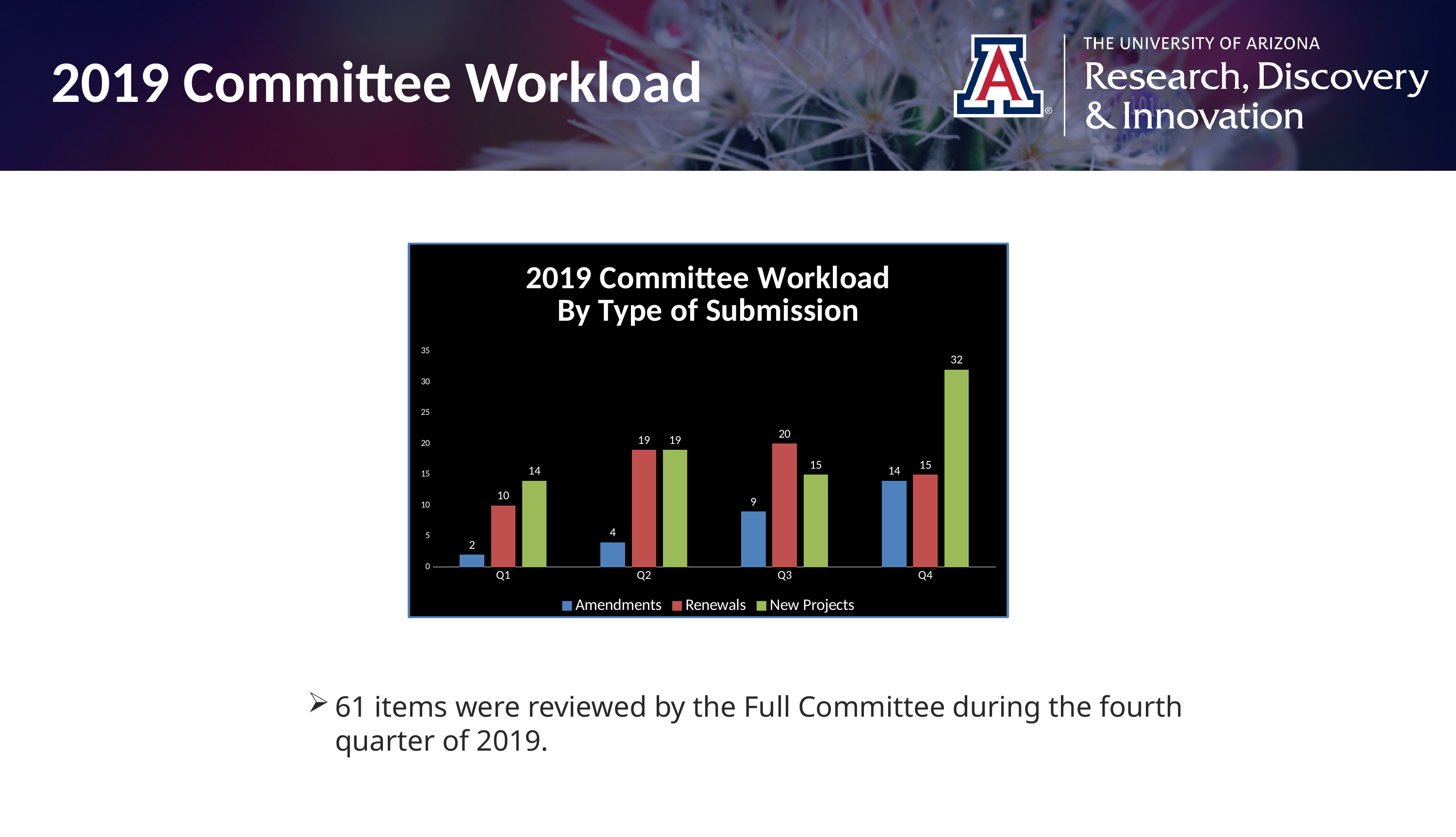
In which quarter is the Amendments value lowest? Q1 What is the value for New Projects in Q4? 32 How many quarters are shown on the x axis? 4 In which quarter is the New Projects value highest? Q4 Which is larger in Q3: Renewals or New Projects? Renewals What kind of chart is shown on the slide? Bar chart Do the Amendments values rise or fall from Q1 to Q4? Rise How many series does the legend list? 3 What is the value for Amendments in Q1? 2 What is the value for Renewals in Q3? 20 What colour represents Renewals in the chart? Red What is the difference between New Projects and Amendments in Q4? 18